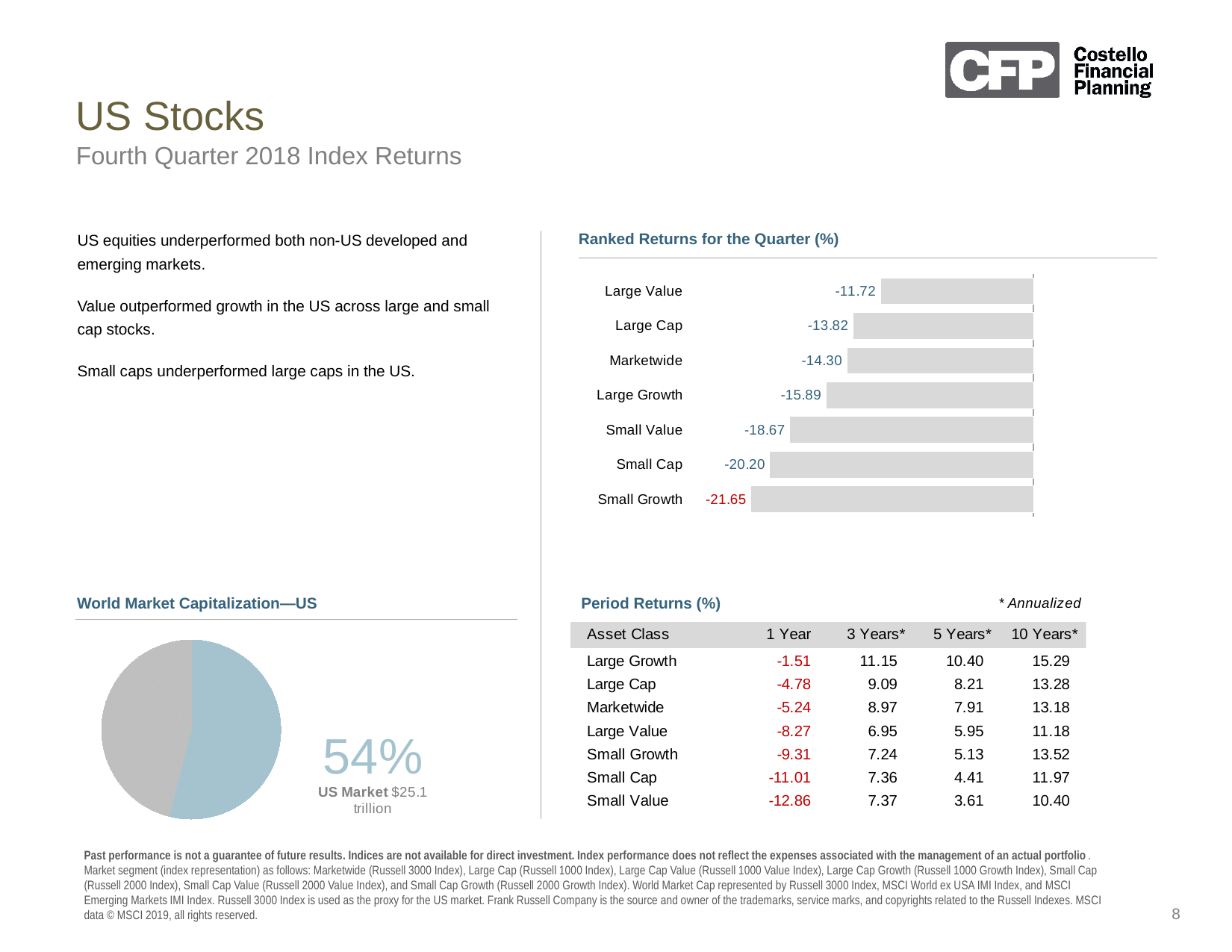
In the Ranked Returns for the Quarter chart, which is larger, the value for Large Growth or Small Value? Large Growth How many categories are shown in the Ranked Returns for the Quarter chart? 7 In the Ranked Returns for the Quarter chart, what is the difference between the Large Cap and Marketwide values? 0.48 In the Ranked Returns for the Quarter chart, what is the value for Large Value? -11.72 In the Ranked Returns for the Quarter chart, which category has the lowest return? Small Growth In the Ranked Returns for the Quarter chart, what is the difference between the Large Value and Small Growth values? 9.93 In the Ranked Returns for the Quarter chart, what is the value for Marketwide? -14.30 What kind of chart is the Ranked Returns for the Quarter chart? Bar chart In the Ranked Returns for the Quarter chart, which category has the highest return? Large Value In the Ranked Returns for the Quarter chart, what is the value for Small Cap? -20.20 In the World Market Capitalization—US chart, what share does the US Market represent? 54% What kind of chart is the World Market Capitalization—US chart? Pie chart